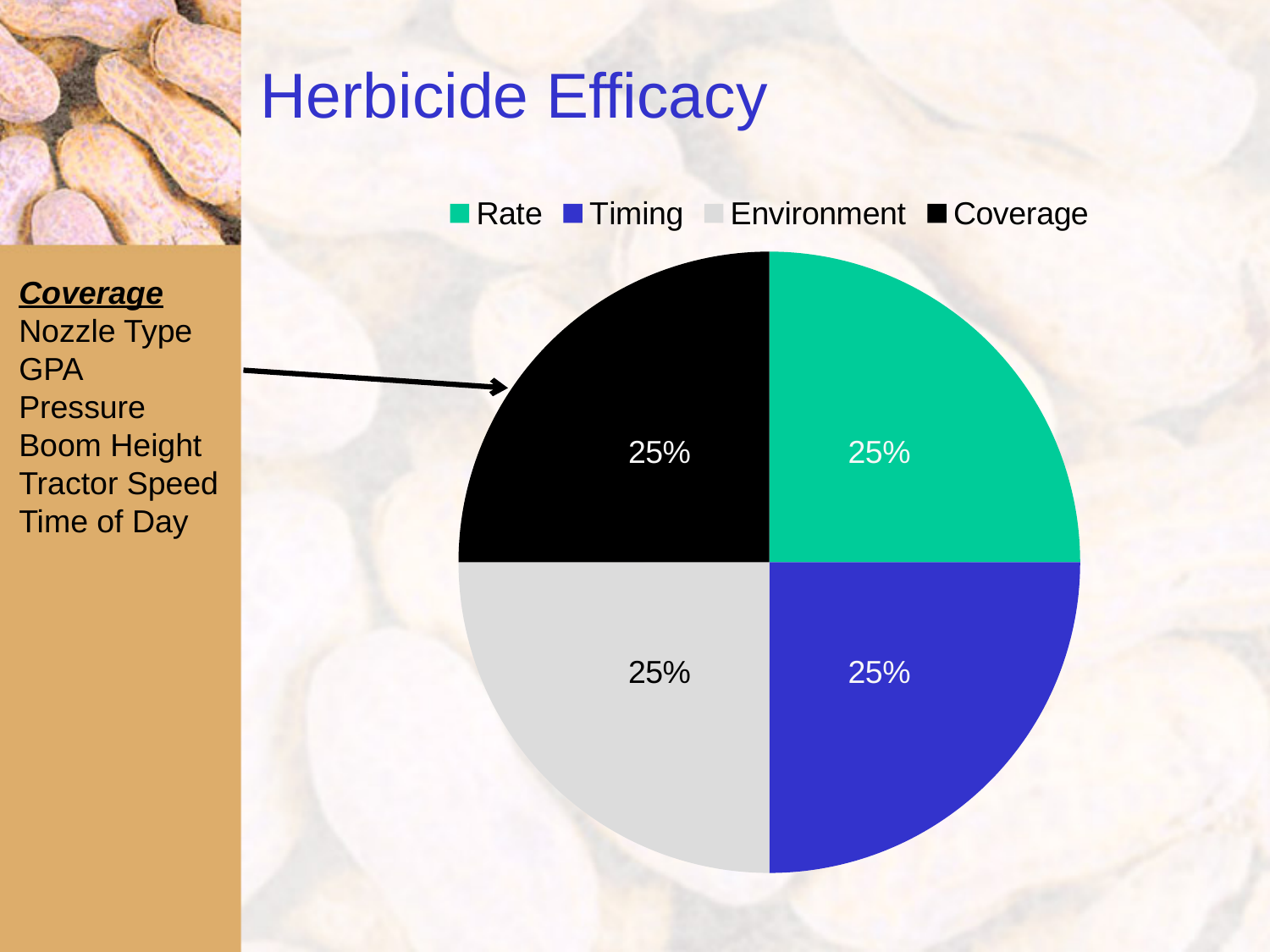
How many slices does the pie chart have? 4 What kind of chart is shown on the slide? pie chart What share of the pie does the Rate slice represent? 25% What share of the pie does the Environment slice represent? 25% What share of the pie does the Timing slice represent? 25% How many entries does the legend list? 4 What is the combined share of the Rate and Coverage slices? 50% Which legend entry is shown in light grey? Environment Which legend entry is shown in black? Coverage What is the difference between the Rate share and the Timing share? 0%